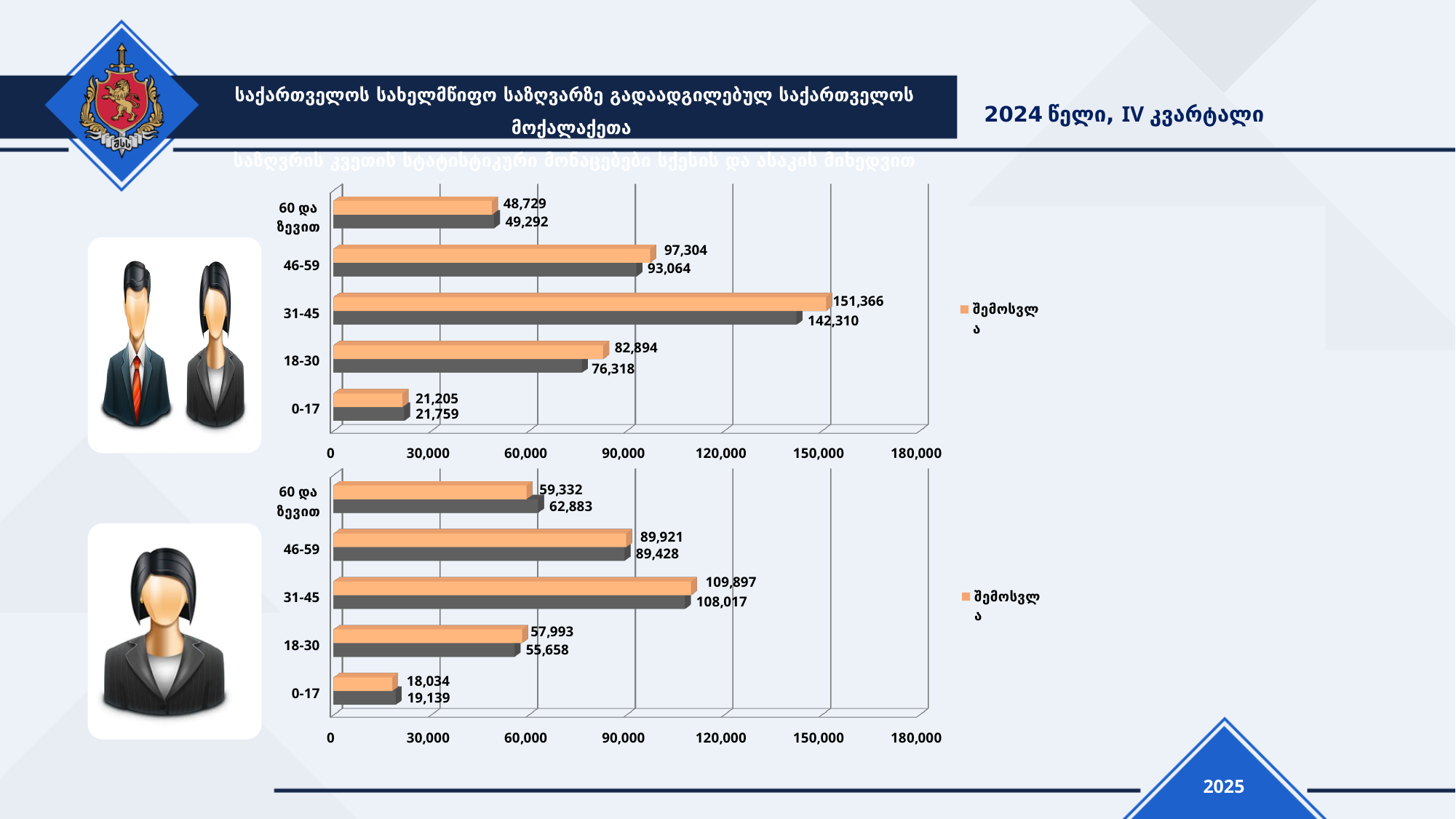
What colour represents the შემოსვლა series in the legend of the top chart? orange What type of chart is the top chart? bar chart In the top chart, is the orange value for the 18-30 age group greater or less than 90,000? less In the bottom chart, what is the difference between the grey and orange values for the 60 და ზევით age group? 3,551 In the top chart, what is the შემოსვლა (orange) value for the 31-45 age group? 151,366 In the bottom chart, which age group has the lowest შემოსვლა (orange) value? 0-17 In the top chart, what is the difference between the orange and grey values for the 31-45 age group? 9,056 In the top chart, what is the შემოსვლა (orange) value for the 0-17 age group? 21,205 How many age groups are shown in the bottom chart? 5 In the bottom chart, for the 46-59 age group, which is larger: the orange bar or the grey bar? the orange bar In the top chart, which age group has the highest შემოსვლა (orange) value? 31-45 In the bottom chart, what is the value of the grey bar for the 60 და ზევით age group? 62,883